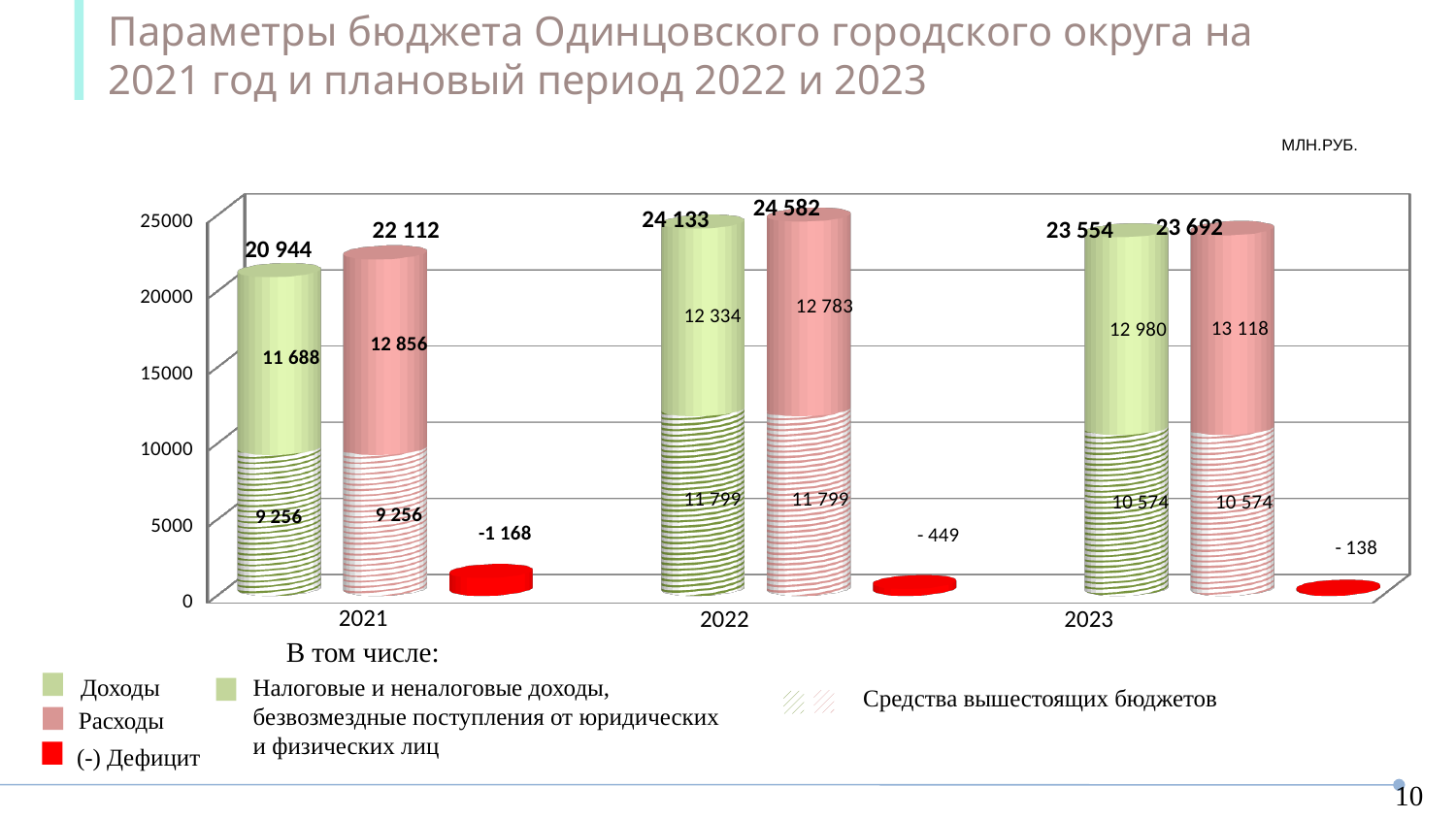
In which year is the total Доходы (income) highest? 2022 Which is larger in 2023: total Доходы or total Расходы? Расходы In which year is the Дефицит (deficit) largest in absolute value? 2021 In what units are the values on the chart given? МЛН.РУБ. What is the total value of Доходы (income) for 2021? 20 944 How many years are shown on the x axis? 3 What kind of chart is shown on the slide? Stacked bar chart Is the total Доходы for 2021 greater or less than 20000? greater What is the value of Средства вышестоящих бюджетов within Доходы for 2022? 11 799 What is the difference between Расходы and Доходы in 2021? 1 168 What is the total value of Расходы (expenses) for 2022? 24 582 What is the value of the Дефицит (deficit) for 2023? - 138